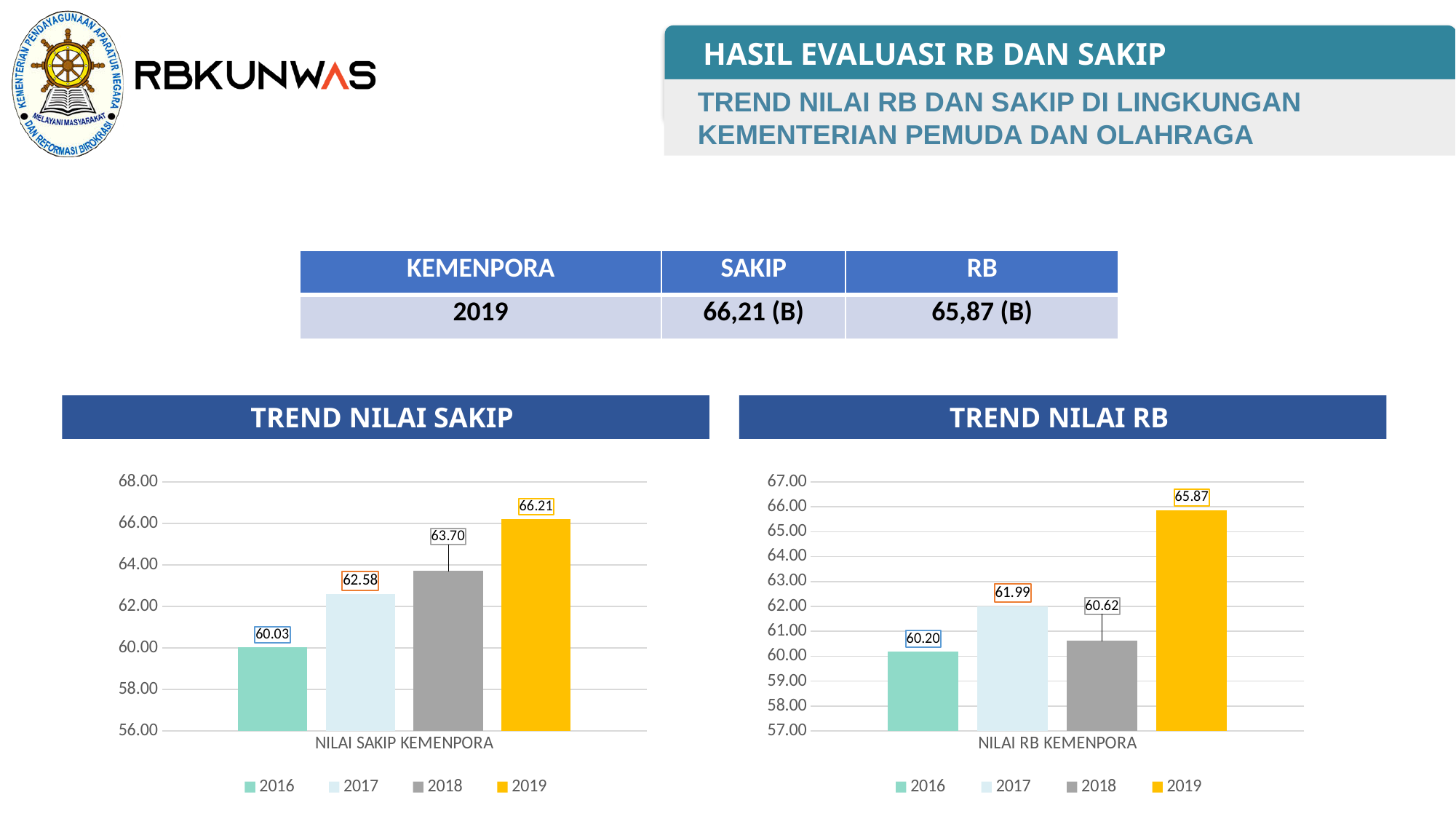
In the TREND NILAI RB chart, what is the value for 2018? 60.62 In the TREND NILAI SAKIP chart, do the values rise or fall from 2016 to 2019? Rise In the TREND NILAI RB chart, which year has the lowest value? 2016 In the TREND NILAI SAKIP chart, is the value for 2018 greater or less than 62.00? greater In the TREND NILAI SAKIP chart, which year has the highest value? 2019 In the TREND NILAI RB chart, what is the difference between the 2019 and 2018 values? 5.25 How many series does the legend of the TREND NILAI RB chart list? 4 In the TREND NILAI SAKIP chart, what is the value for 2017? 62.58 In the TREND NILAI RB chart, what colour is the bar for 2019? Yellow In the TREND NILAI RB chart, which is larger, the value for 2017 or the value for 2018? 2017 What kind of chart is the TREND NILAI SAKIP chart? Bar chart In the TREND NILAI SAKIP chart, what is the difference between the 2019 and 2016 values? 6.18